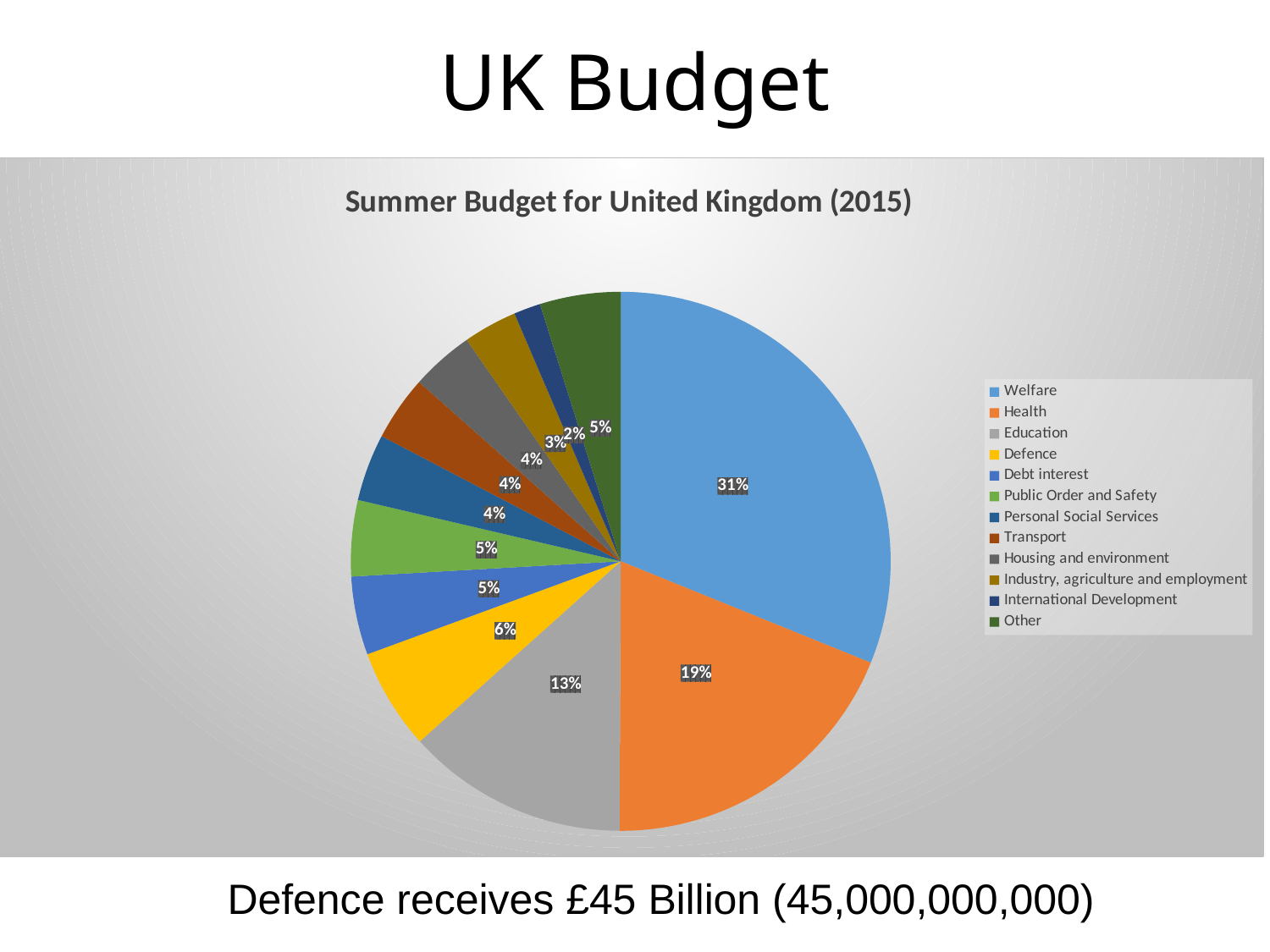
What share of the budget goes to Education? 13% What share of the budget goes to International Development? 2% What is the title of the chart? Summer Budget for United Kingdom (2015) Which category has the smallest share of the budget? International Development How many categories does the pie chart show? 12 Which has a larger share of the budget, Education or Defence? Education What share of the budget goes to Defence? 6% What kind of chart is shown on the slide? Pie chart Which category has the largest share of the budget? Welfare What is the difference in percentage points between the Welfare share and the Health share? 12 percentage points